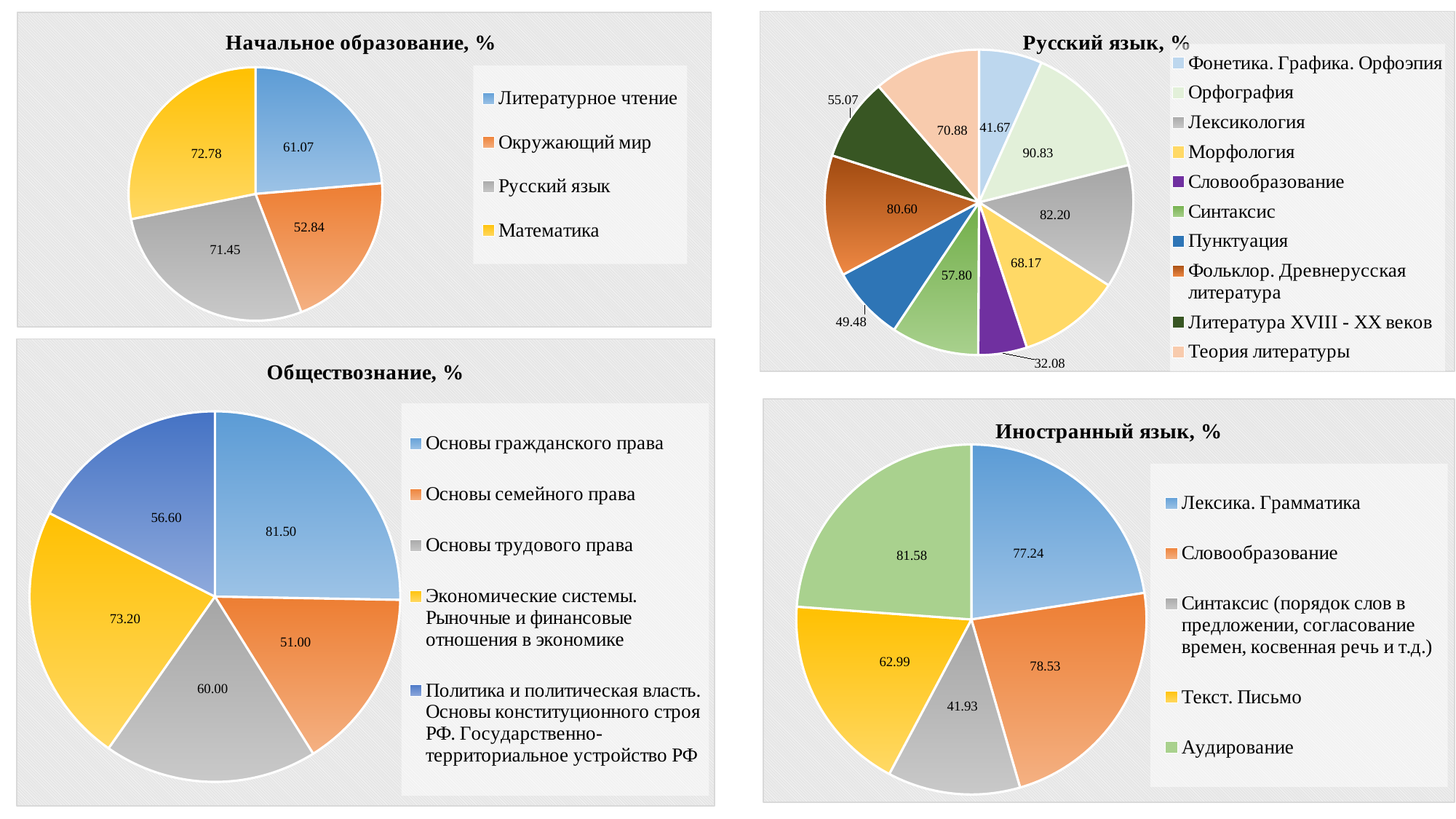
In the "Иностранный язык, %" chart, which category has the lowest value? Синтаксис (порядок слов в предложении, согласование времен, косвенная речь и т.д.) In the "Русский язык, %" chart, which is larger: Лексикология or Фольклор. Древнерусская литература? Лексикология What type of chart is the "Иностранный язык, %" chart? Pie chart In the "Начальное образование, %" chart, what is the difference between Математика and Окружающий мир? 19.94 In the "Русский язык, %" chart, what is the value for Орфография? 90.83 In the "Начальное образование, %" chart, which category has the highest value? Математика In the "Обществознание, %" chart, what is the difference between Основы гражданского права and Основы семейного права? 30.50 In the "Русский язык, %" chart, which category has the lowest value? Словообразование In the "Обществознание, %" chart, what is the value for Основы трудового права? 60.00 In the "Начальное образование, %" chart, what is the value for Окружающий мир? 52.84 In the "Иностранный язык, %" chart, what is the value for Аудирование? 81.58 How many categories does the "Русский язык, %" chart show? 10